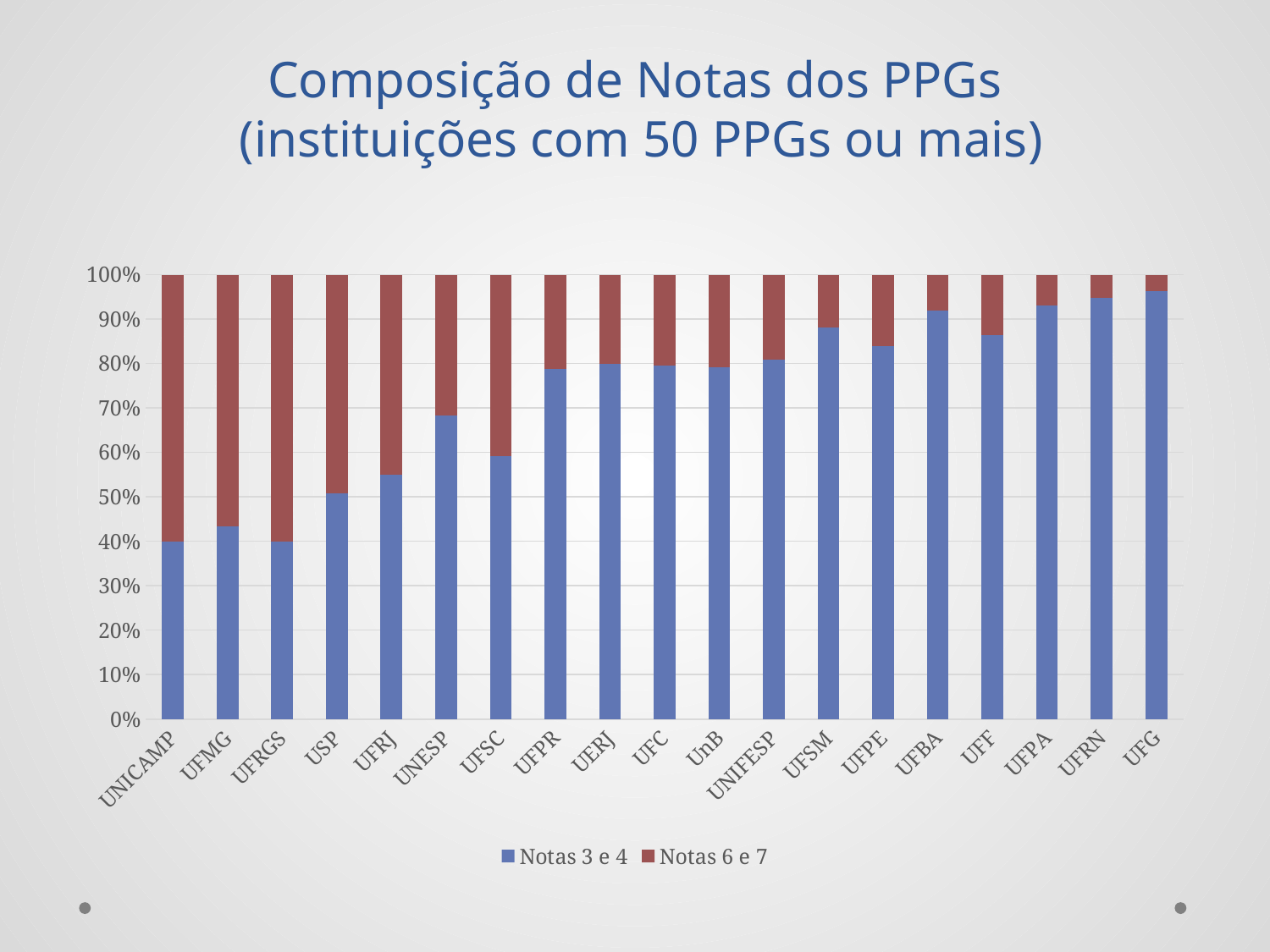
What kind of chart is shown on the slide? Stacked bar chart Is the Notas 3 e 4 value for UFRJ greater or less than 50%? greater How many institutions are shown on the x axis of the chart? 19 How many series does the chart legend list? 2 Is the Notas 3 e 4 value for UNESP greater or less than 70%? less Is the Notas 3 e 4 value for UFSM greater or less than 90%? less Which institution has the lowest share of Notas 6 e 7? UFG Does the share of Notas 3 e 4 generally rise or fall from left to right across the institutions? Rise Which has a larger share of Notas 3 e 4, UNESP or UFSC? UNESP Which institution has the highest share of Notas 3 e 4? UFG What are the two series named in the legend? Notas 3 e 4 and Notas 6 e 7